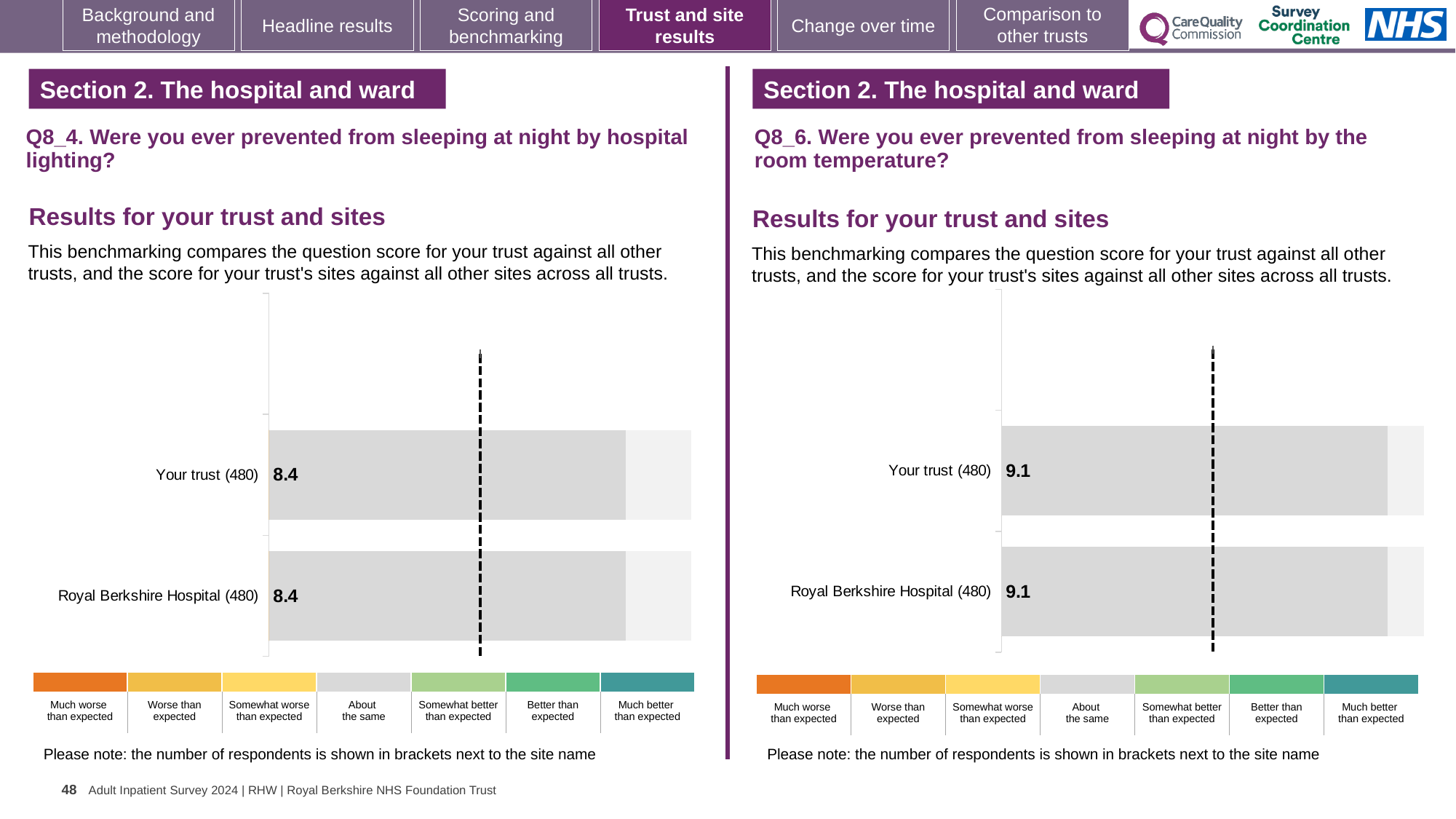
On the Q8_6 chart (room temperature), what is the score for Royal Berkshire Hospital (480)? 9.1 How many categories does the colour legend below the Q8_4 chart (hospital lighting) list? 7 On the Q8_6 chart (room temperature), which legend category does the grey colour of the bars correspond to? About the same On the Q8_4 chart (hospital lighting), what is the score for Royal Berkshire Hospital (480)? 8.4 How many respondents are shown in brackets for Royal Berkshire Hospital on the Q8_6 chart (room temperature)? 480 How many bars are plotted on the Q8_6 chart (room temperature)? 2 On the Q8_6 chart (room temperature), what is the score for Your trust (480)? 9.1 On the Q8_4 chart (hospital lighting), what is the difference between the score for Your trust and the score for Royal Berkshire Hospital? 0.0 What kind of chart is used for the Q8_4 results (hospital lighting)? Bar chart On the Q8_6 chart (room temperature), what is the difference between the score for Your trust and the score for Royal Berkshire Hospital? 0.0 On the Q8_4 chart (hospital lighting), what is the score for Your trust (480)? 8.4 How many bars are plotted on the Q8_4 chart (hospital lighting)? 2